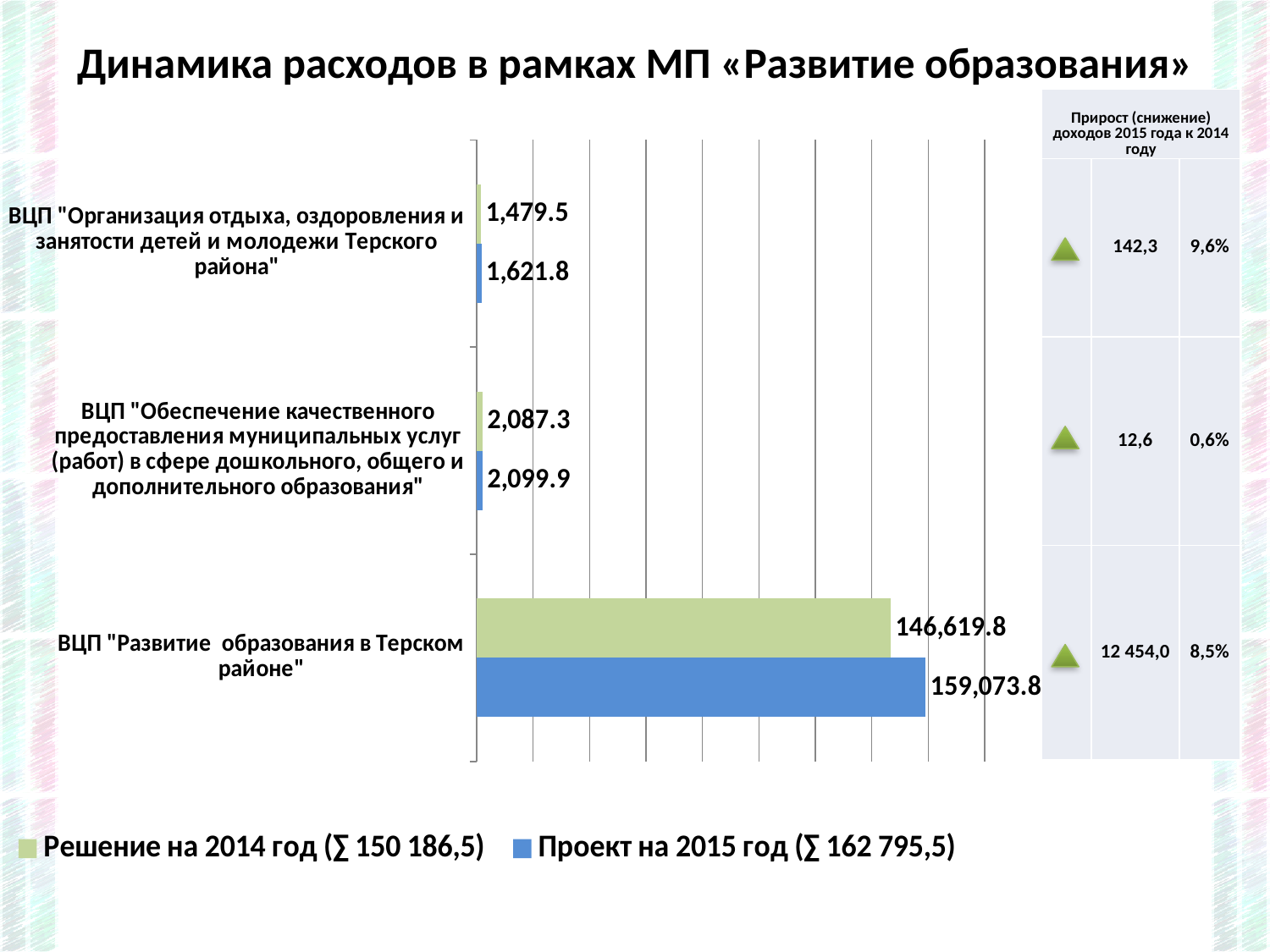
Which category has the lowest value for "Решение на 2014 год"? ВЦП "Организация отдыха, оздоровления и занятости детей и молодежи Терского района" What is the difference between the 2015 and 2014 values for ВЦП "Организация отдыха, оздоровления и занятости детей и молодежи Терского района"? 142.3 Which category has the highest value for "Проект на 2015 год"? ВЦП "Развитие образования в Терском районе" What is the value of "Решение на 2014 год" for ВЦП "Организация отдыха, оздоровления и занятости детей и молодежи Терского района"? 1,479.5 What is the value of "Решение на 2014 год" for ВЦП "Развитие образования в Терском районе"? 146,619.8 For ВЦП "Развитие образования в Терском районе", which is larger: the 2014 value or the 2015 value? 2015 value (159,073.8) What is the difference between the 2015 and 2014 values for ВЦП "Развитие образования в Терском районе"? 12,454.0 What type of chart is shown on the slide? Bar chart How many series does the legend list? 2 What is the value of "Проект на 2015 год" for ВЦП "Обеспечение качественного предоставления муниципальных услуг (работ) в сфере дошкольного, общего и дополнительного образования"? 2,099.9 How many categories are shown on the chart? 3 What is the value of "Проект на 2015 год" for ВЦП "Развитие образования в Терском районе"? 159,073.8